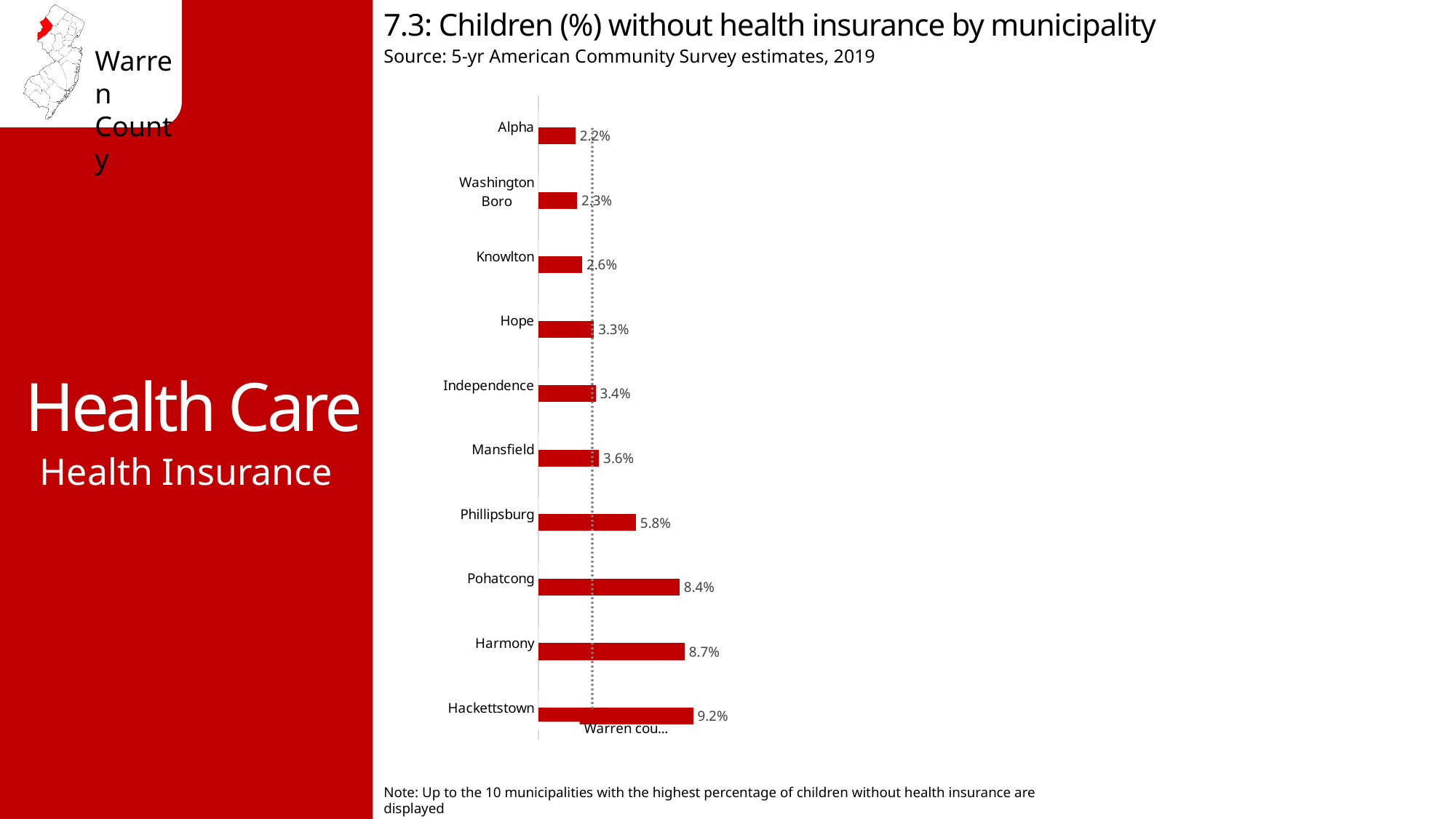
Which municipality has the highest percentage of children without health insurance? Hackettstown Which municipality has the lowest percentage of children without health insurance? Alpha What is the title of the chart? 7.3: Children (%) without health insurance by municipality What is the value shown for Phillipsburg? 5.8% Which has a higher value, Mansfield or Independence? Mansfield Which has a higher value, Pohatcong or Hope? Pohatcong What is the difference between the values for Hackettstown and Harmony? 0.5% What kind of chart is shown on the slide? Bar chart What is the difference between the values for Pohatcong and Phillipsburg? 2.6% What percentage of children in Hackettstown are without health insurance? 9.2% How many municipalities are shown in the chart? 10 What is the value shown for Knowlton? 2.6%